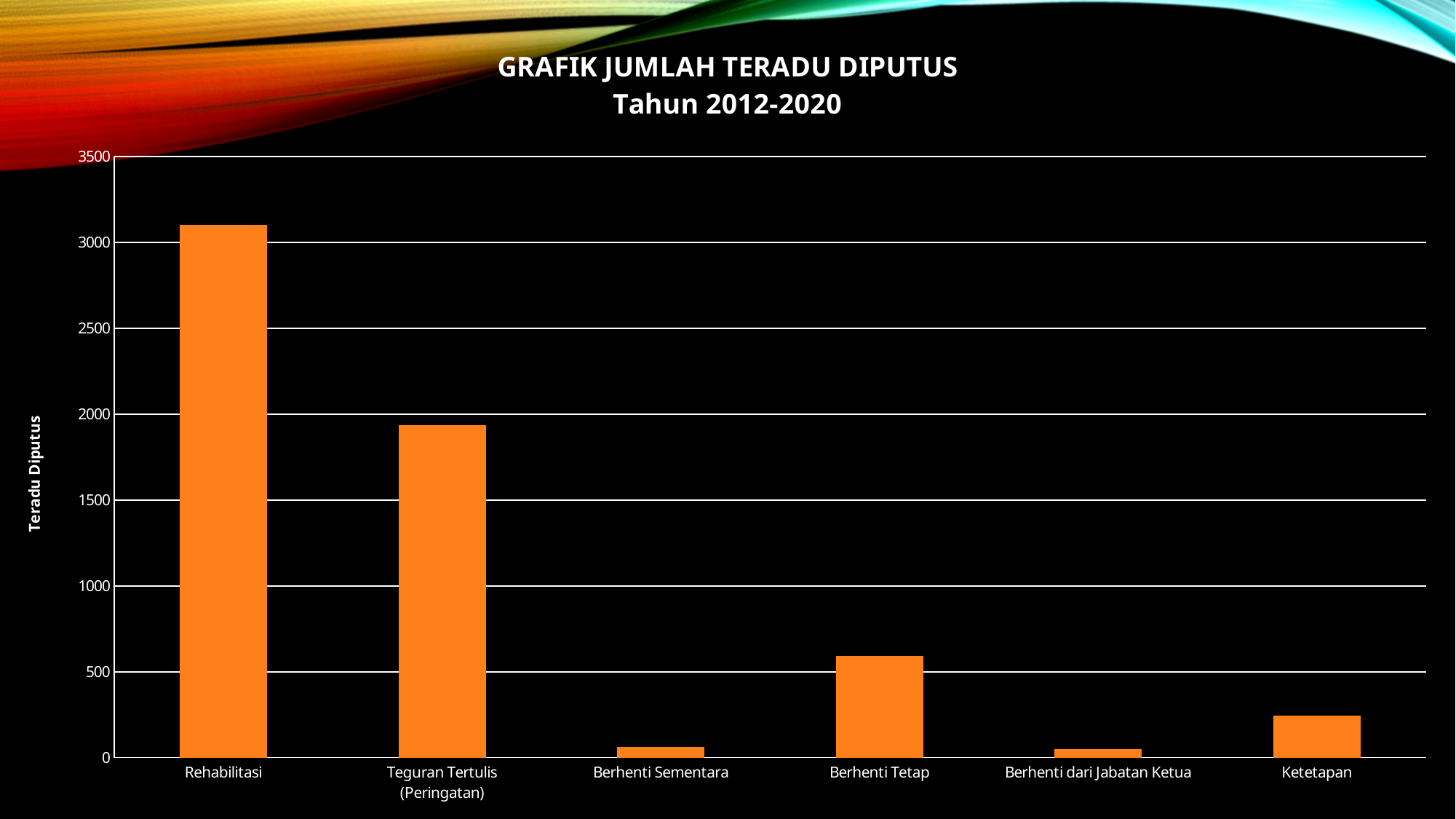
Is the value for Berhenti Sementara greater or less than 500? less Is the value for Teguran Tertulis (Peringatan) greater or less than 2000? less Which is larger, the value for Berhenti Tetap or the value for Ketetapan? Berhenti Tetap What type of chart is shown on the slide? bar chart Which category has the highest value in the chart? Rehabilitasi How many categories are shown on the x axis of the chart? 6 Is the value for Rehabilitasi greater or less than 3000? greater Which is larger, the value for Teguran Tertulis (Peringatan) or the value for Rehabilitasi? Rehabilitasi What is the label of the vertical axis? Teradu Diputus What is the title of the chart? GRAFIK JUMLAH TERADU DIPUTUS Tahun 2012-2020